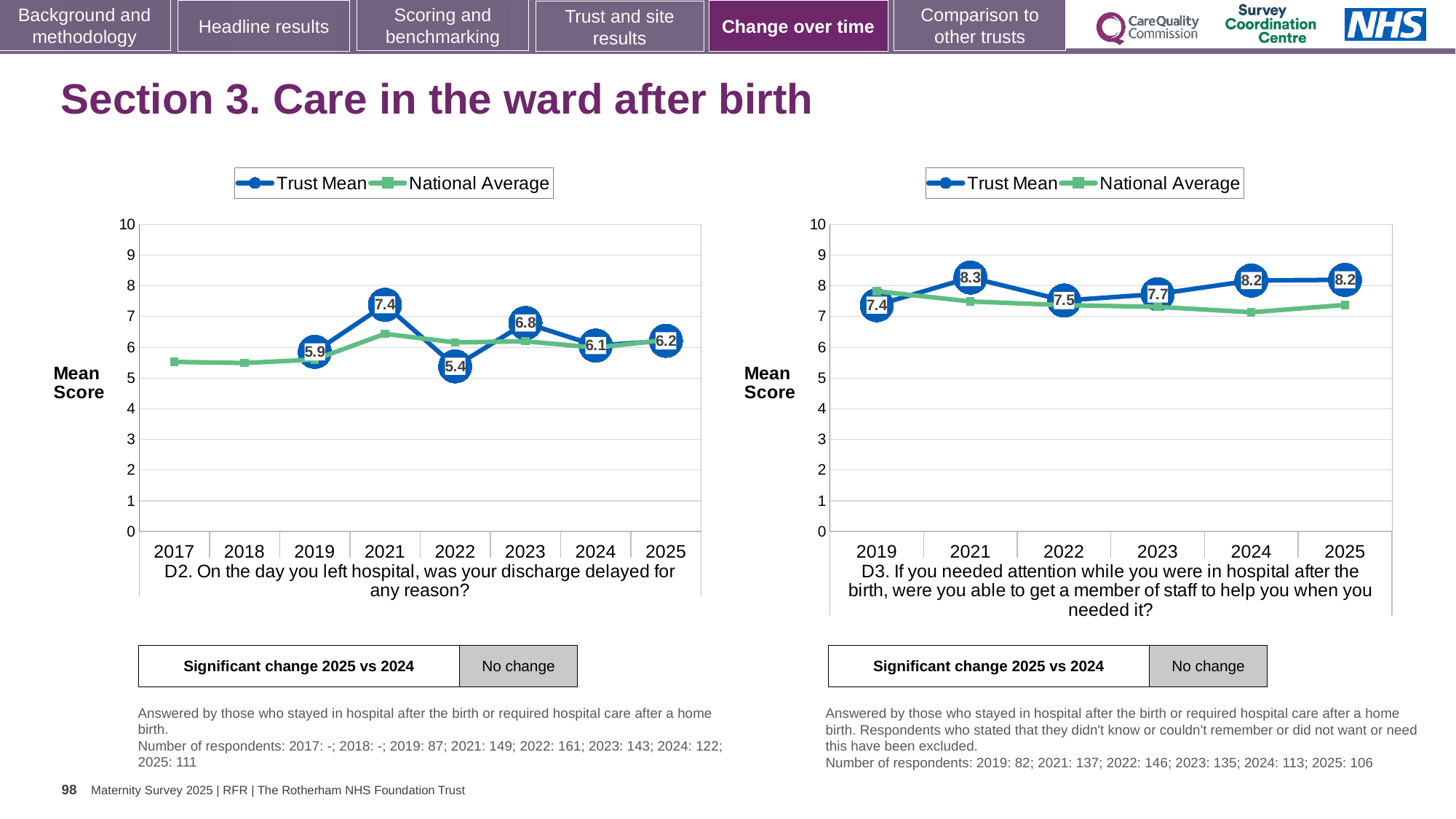
In the D3 chart (right), what is the Trust Mean for 2019? 7.4 In the D2 chart (left), which year has the lowest Trust Mean? 2022 In the D2 chart (left), what is the Trust Mean for 2022? 5.4 What type of chart is the D3 chart (right)? Line chart In the D2 chart (left), what is the Trust Mean for 2021? 7.4 In the D2 chart (left), which year has the highest Trust Mean? 2021 In the D2 chart (left), how many series does the legend list? 2 In the D3 chart (right), is the National Average for 2024 greater or less than 8? less In the D3 chart (right), is the Trust Mean for 2021 larger or smaller than the Trust Mean for 2022? larger In the D2 chart (left), what is the difference between the Trust Mean in 2021 and in 2022? 2.0 In the D3 chart (right), how many years are plotted on the x axis? 6 In the D3 chart (right), which year has the highest Trust Mean? 2021